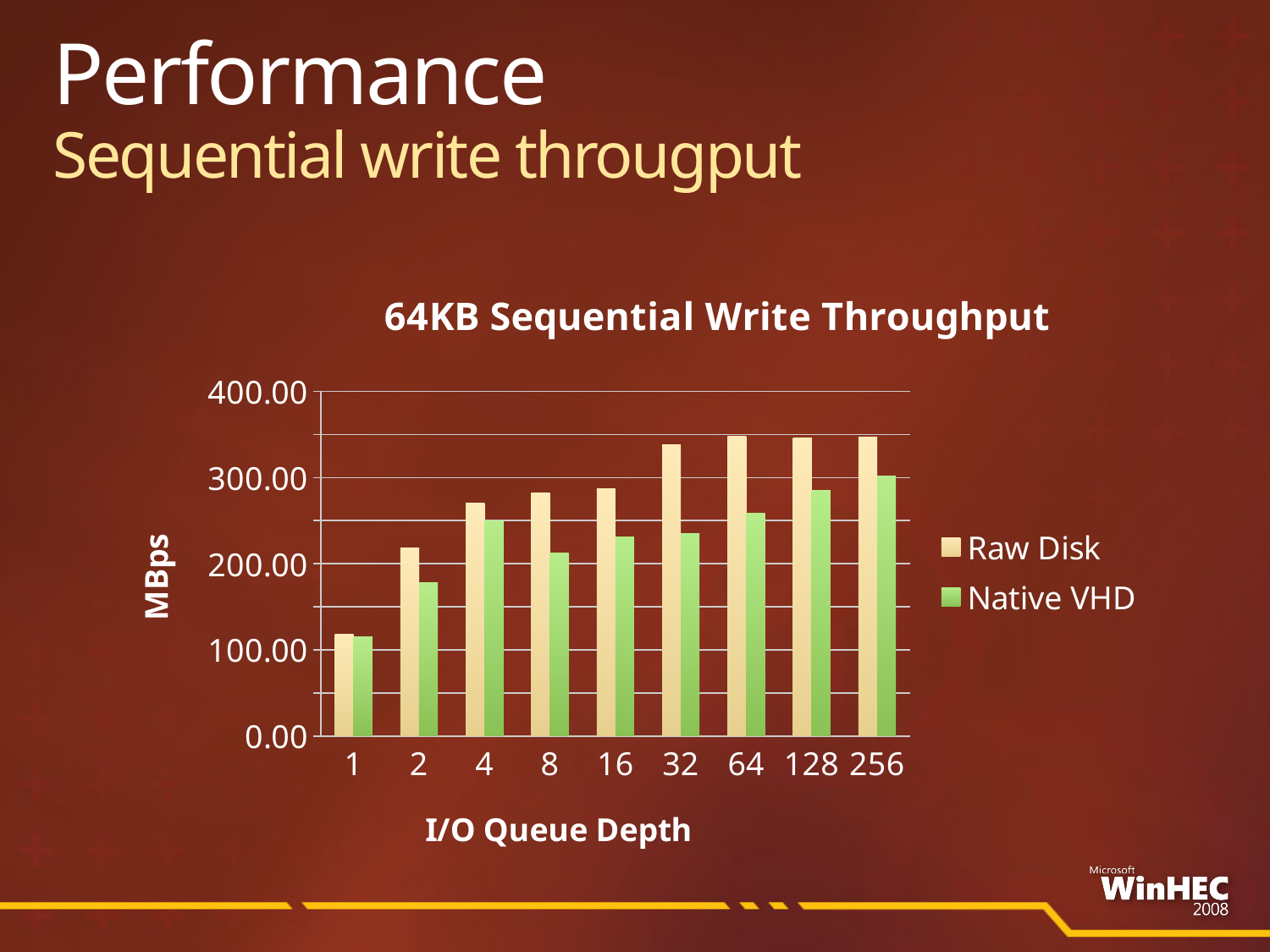
At which I/O queue depth is the Native VHD value highest? 256 At I/O queue depth 2, which is larger: Raw Disk or Native VHD? Raw Disk Do the Raw Disk values generally rise or fall as I/O queue depth increases? rise How many series does the legend list? 2 Is the Native VHD value at I/O queue depth 128 greater or less than 300? less Is the Native VHD value at I/O queue depth 2 greater or less than 200? less At which I/O queue depth is the Raw Disk value lowest? 1 What is the label of the y axis? MBps What is the title of the chart? 64KB Sequential Write Throughput What kind of chart is shown on the slide? bar chart How many I/O queue depth categories are shown on the x axis? 9 Is the Raw Disk value at I/O queue depth 32 greater or less than 300? greater